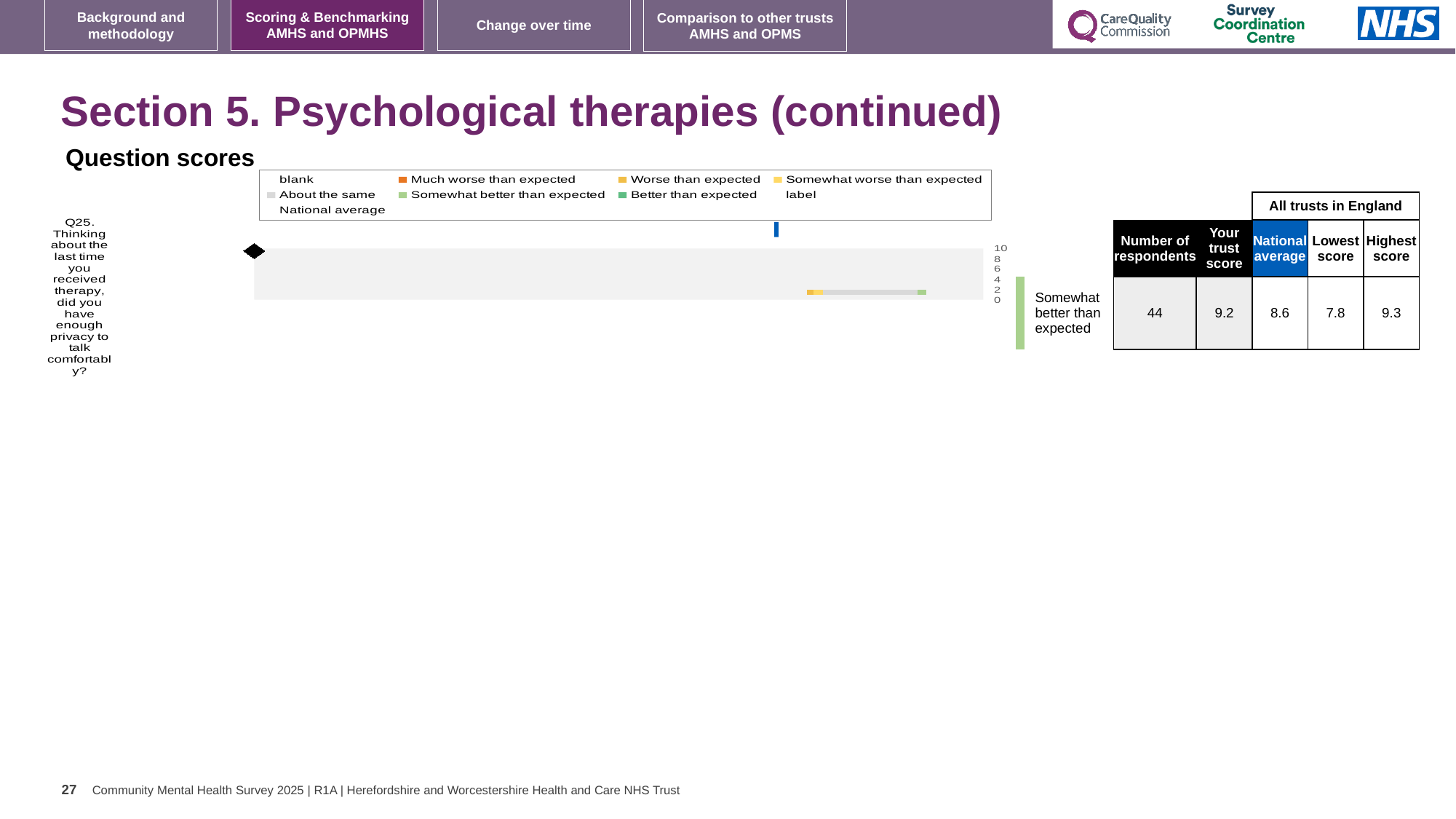
What is the "Your trust score" for Q25 in the table next to the chart? 9.2 Which is larger for Q25: the trust score or the national average? trust score In the chart legend, what colour represents "Better than expected"? green What is the lowest score among all trusts in England for Q25? 7.8 What is the national average score for Q25 shown in the table? 8.6 How many questions are plotted in the "Question scores" chart? 1 Which question is plotted in the "Question scores" chart? Q25 What benchmark category is Q25 assigned to on the slide? Somewhat better than expected What kind of chart is shown under the heading "Question scores"? bar chart What is the highest score among all trusts in England for Q25? 9.3 How many respondents answered Q25? 44 What is the difference between the highest score and the lowest score for Q25? 1.5